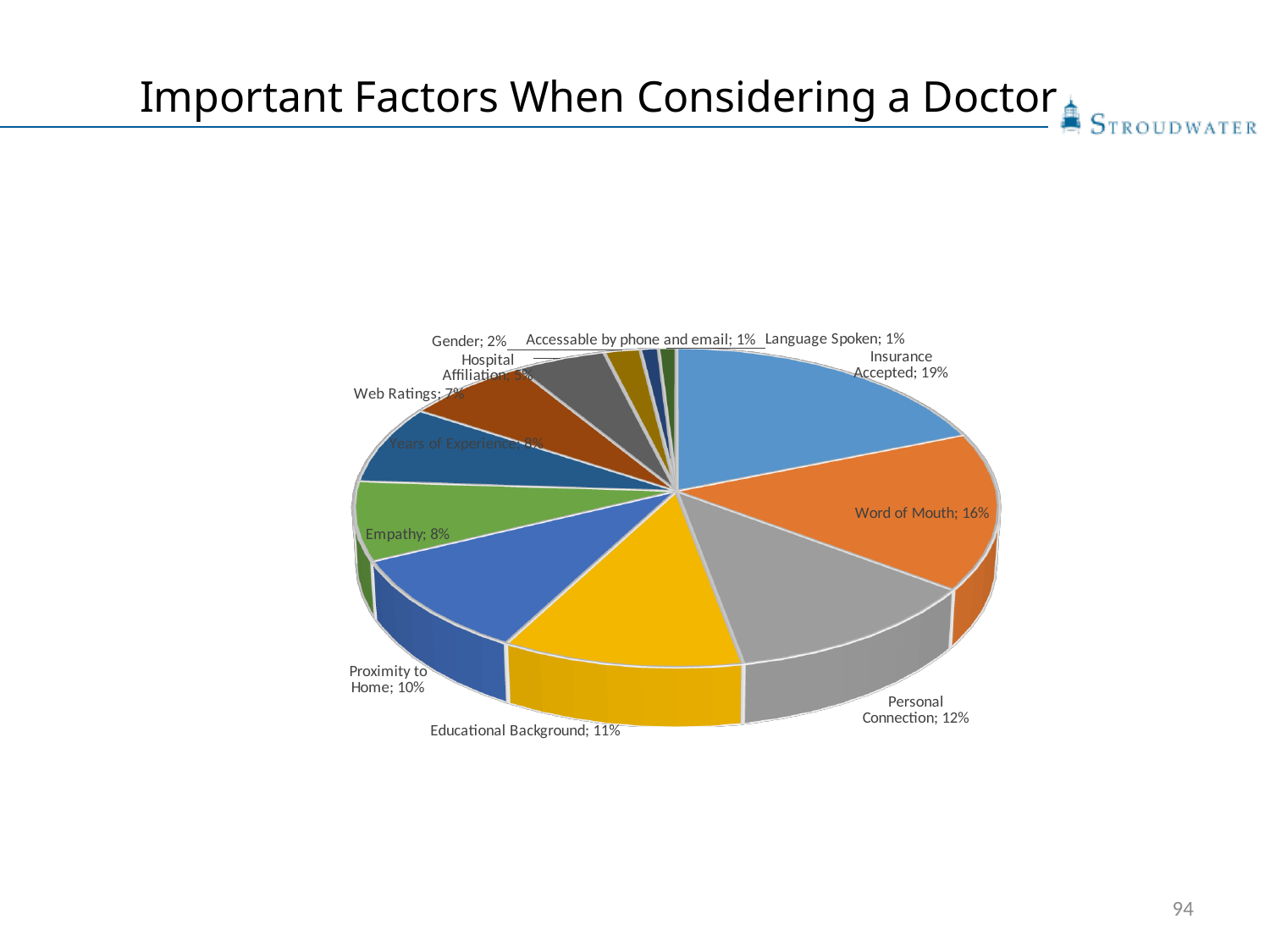
What is the title of the chart on the slide? Important Factors When Considering a Doctor Which factor has the largest share of the pie? Insurance Accepted What percentage is shown for Personal Connection? 12% What percentage is shown for Educational Background? 11% What is the difference in percentage points between Insurance Accepted and Word of Mouth? 3 What kind of chart is shown on the slide? pie chart What percentage is shown for Empathy? 8% What percentage is shown for Proximity to Home? 10% Which is larger, Word of Mouth or Personal Connection? Word of Mouth How many slices does the pie chart have? 12 What share of the pie is Insurance Accepted? 19% What share of the pie is Word of Mouth? 16%